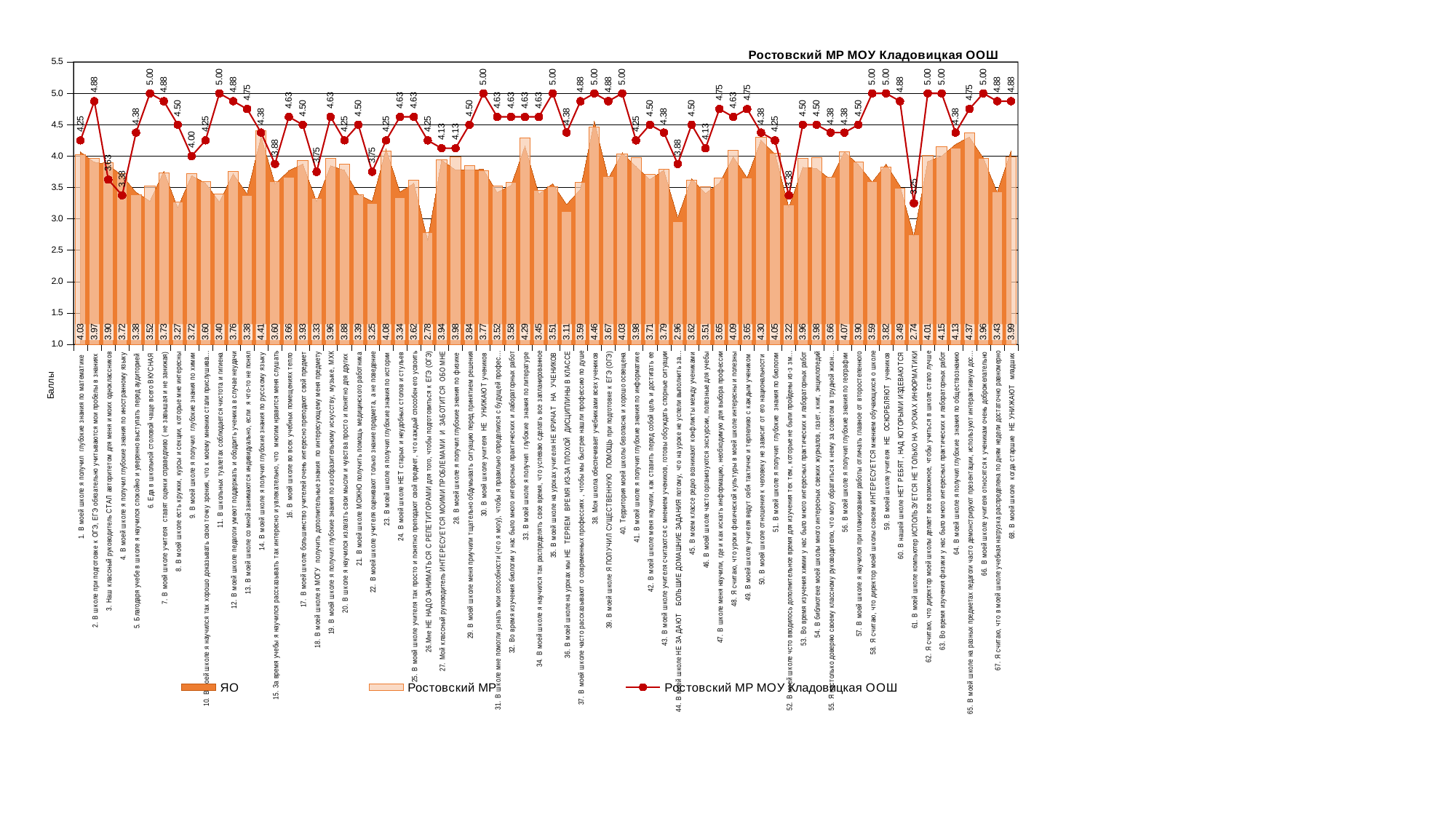
What is the label of the vertical axis? Баллы What is the Ростовский МР МОУ Кладовицкая ООШ value for item 1 "В моей школе я получил глубокие знания по математике"? 4.25 How many series does the legend list? 3 What kind of chart is shown on the slide? A combination chart with an area series, bars and a line What is the lowest Ростовский МР МОУ Кладовицкая ООШ value shown on the chart? 3.25 What is the title of the chart? Ростовский МР МОУ Кладовицкая ООШ What is the Ростовский МР МОУ Кладовицкая ООШ value for item 2 "В школе при подготовке к ОГЭ, ЕГЭ обязательно учитываются мои пробелы в знаниях"? 4.88 For item 2, which is larger: the ЯО value or the Ростовский МР МОУ Кладовицкая ООШ value? Ростовский МР МОУ Кладовицкая ООШ